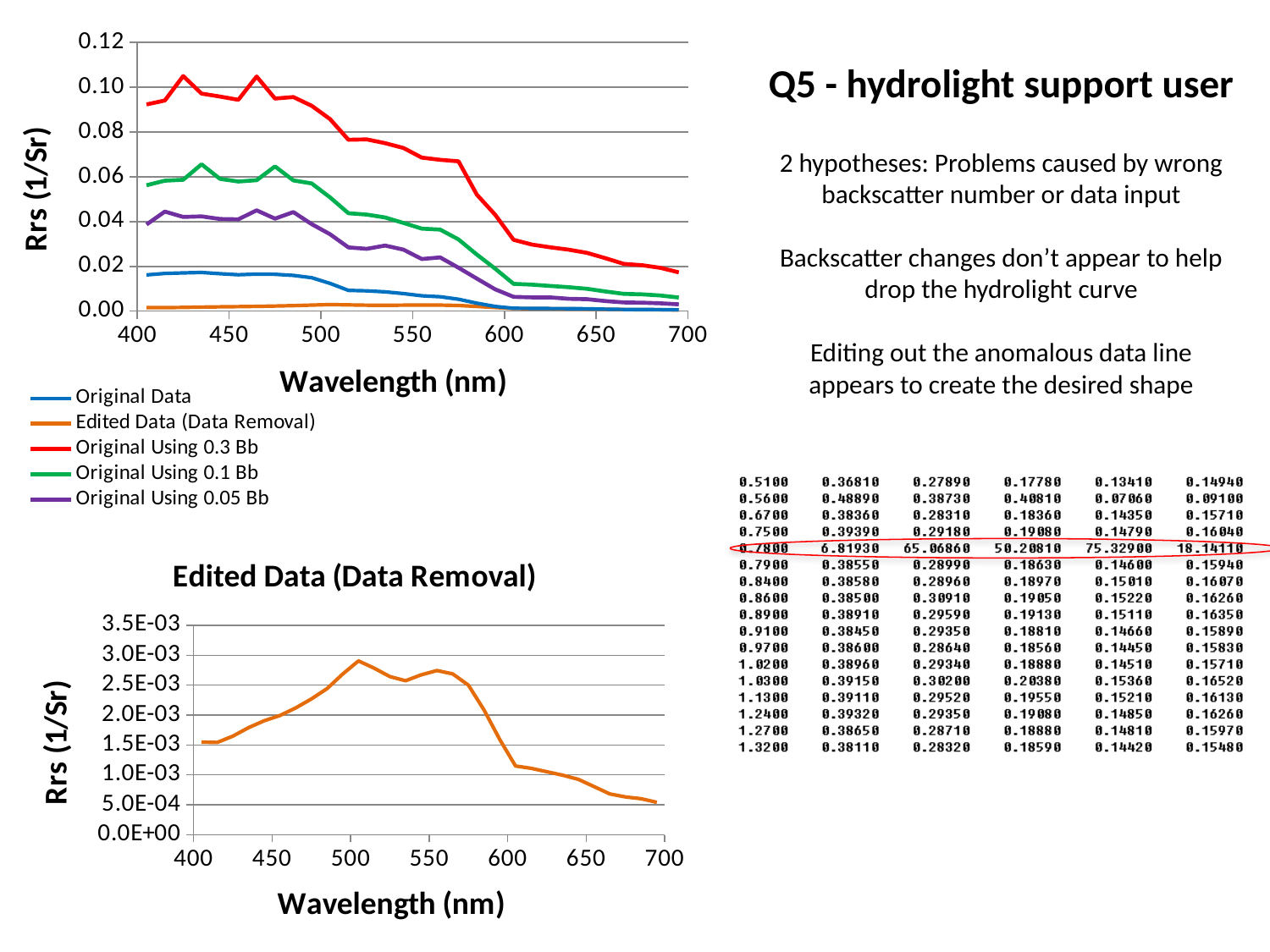
In the top-left chart, do the values for Original Using 0.3 Bb generally rise or fall as wavelength increases from 400 to 700 nm? fall In the bottom-left chart 'Edited Data (Data Removal)', is the value at 695 nm greater or less than 1.0E-03? less In the top-left chart, at 500 nm, which is larger: Original Using 0.3 Bb or Original Using 0.1 Bb? Original Using 0.3 Bb What kind of chart is the top-left chart on the slide? line chart How many series does the legend of the top-left chart list? 5 In the top-left chart, is the value for Original Using 0.1 Bb at 405 nm greater or less than 0.04? greater What is the y-axis title of the top-left chart? Rrs (1/Sr) What is the title of the bottom-left chart? Edited Data (Data Removal) In the top-left chart, which series has the highest values across the wavelength range? Original Using 0.3 Bb In the top-left chart, which series has the lowest values across the wavelength range? Edited Data (Data Removal) In the bottom-left chart 'Edited Data (Data Removal)', is the peak value near 505 nm greater or less than 2.5E-03? greater